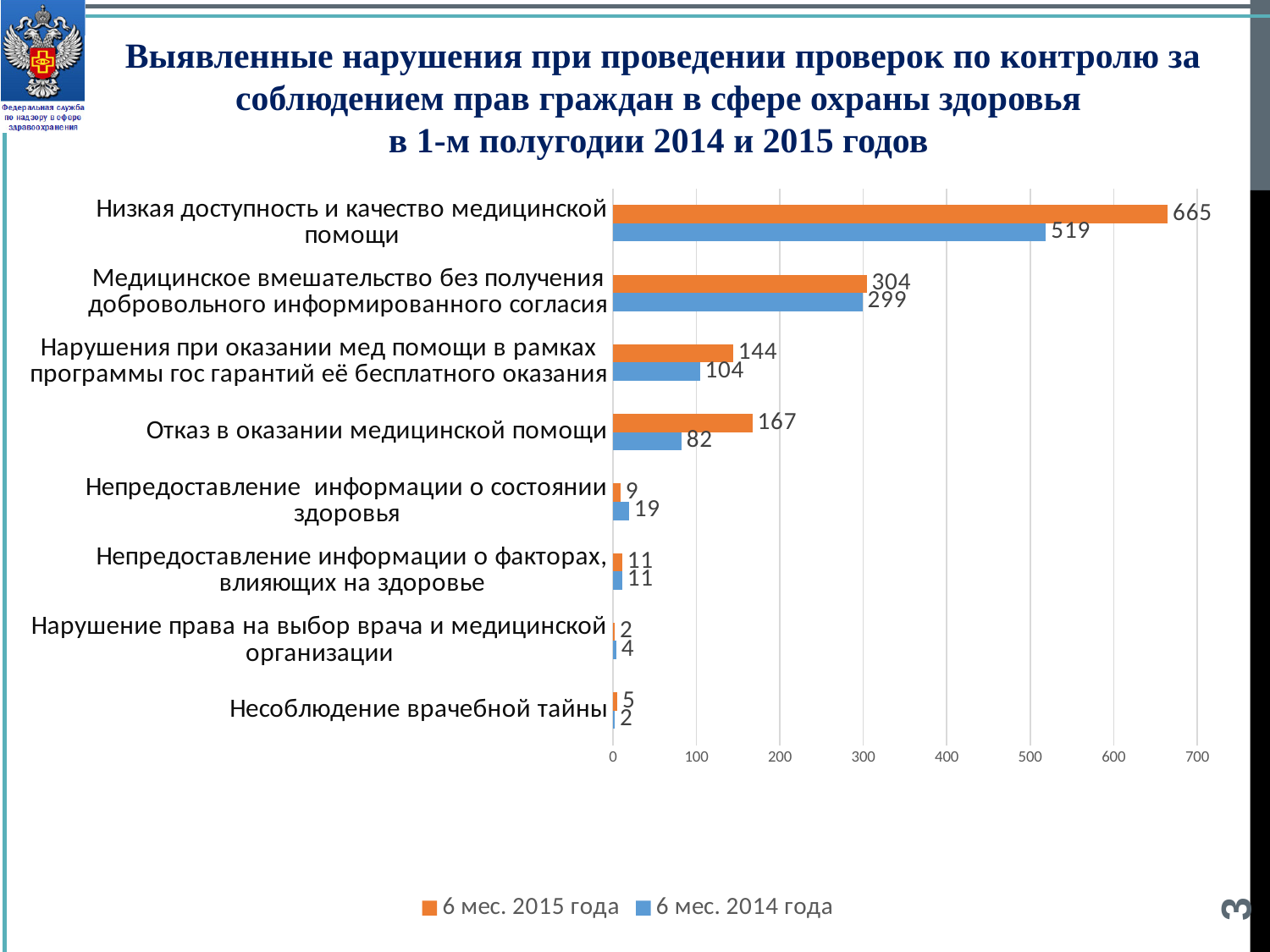
For «Непредоставление информации о состоянии здоровья», which series has the larger value: «6 мес. 2015 года» or «6 мес. 2014 года»? 6 мес. 2014 года How many categories are shown on the chart? 8 What is the value for «Отказ в оказании медицинской помощи» in the «6 мес. 2014 года» series? 82 Which category has the lowest value in the «6 мес. 2015 года» series? Нарушение права на выбор врача и медицинской организации How many series does the legend list? 2 What is the value for «Низкая доступность и качество медицинской помощи» in the «6 мес. 2015 года» series? 665 What is the difference between the «6 мес. 2015 года» and «6 мес. 2014 года» values for «Отказ в оказании медицинской помощи»? 85 What is the difference between the «6 мес. 2015 года» and «6 мес. 2014 года» values for «Низкая доступность и качество медицинской помощи»? 146 What is the value for «Непредоставление информации о состоянии здоровья» in the «6 мес. 2015 года» series? 9 Which category has the highest value in the «6 мес. 2014 года» series? Низкая доступность и качество медицинской помощи What kind of chart is shown on the slide? Bar chart Is the «6 мес. 2014 года» value for «Медицинское вмешательство без получения добровольного информированного согласия» greater or less than 200? greater